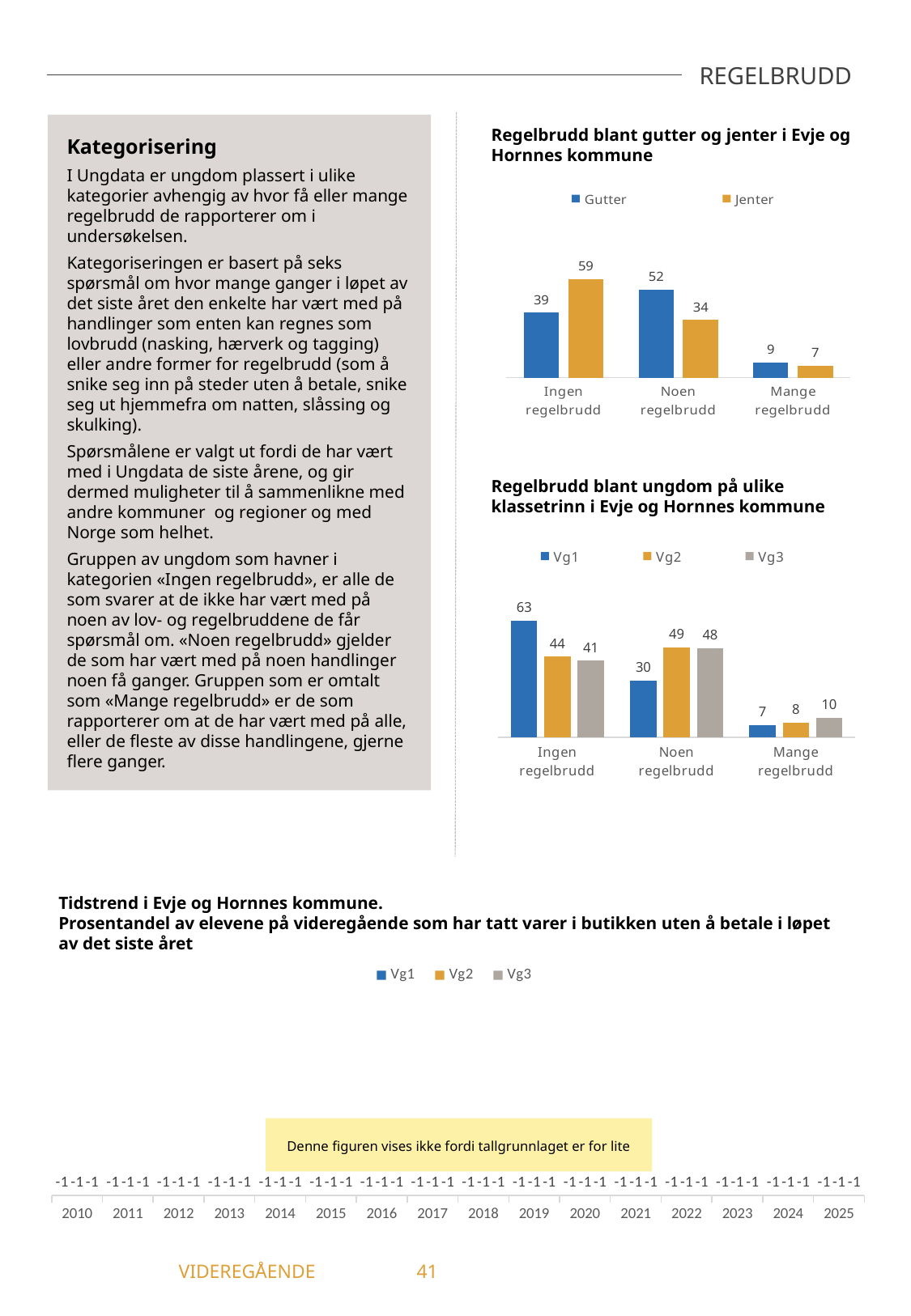
In the chart 'Regelbrudd blant gutter og jenter i Evje og Hornnes kommune', what is the value for Jenter in the 'Ingen regelbrudd' category? 59 In the chart 'Regelbrudd blant ungdom på ulike klassetrinn i Evje og Hornnes kommune', what is the value for Vg1 in the 'Ingen regelbrudd' category? 63 In the chart 'Regelbrudd blant ungdom på ulike klassetrinn i Evje og Hornnes kommune', which series has the highest value in the 'Noen regelbrudd' category? Vg2 In the chart 'Regelbrudd blant gutter og jenter i Evje og Hornnes kommune', what is the difference between Jenter and Gutter in the 'Ingen regelbrudd' category? 20 How many series does the legend list in the chart 'Regelbrudd blant gutter og jenter i Evje og Hornnes kommune'? 2 What kind of chart is 'Regelbrudd blant ungdom på ulike klassetrinn i Evje og Hornnes kommune'? Bar chart In the chart 'Regelbrudd blant ungdom på ulike klassetrinn i Evje og Hornnes kommune', what is the value for Vg3 in the 'Mange regelbrudd' category? 10 How many categories are shown on the x axis of the chart 'Regelbrudd blant ungdom på ulike klassetrinn i Evje og Hornnes kommune'? 3 In the chart 'Regelbrudd blant ungdom på ulike klassetrinn i Evje og Hornnes kommune', what is the difference between Vg1 and Vg2 in the 'Ingen regelbrudd' category? 19 In the chart 'Regelbrudd blant gutter og jenter i Evje og Hornnes kommune', what is the value for Gutter in the 'Noen regelbrudd' category? 52 In the chart 'Regelbrudd blant gutter og jenter i Evje og Hornnes kommune', which is larger in the 'Noen regelbrudd' category, Gutter or Jenter? Gutter In the chart 'Regelbrudd blant gutter og jenter i Evje og Hornnes kommune', which category has the lowest value for Gutter? Mange regelbrudd